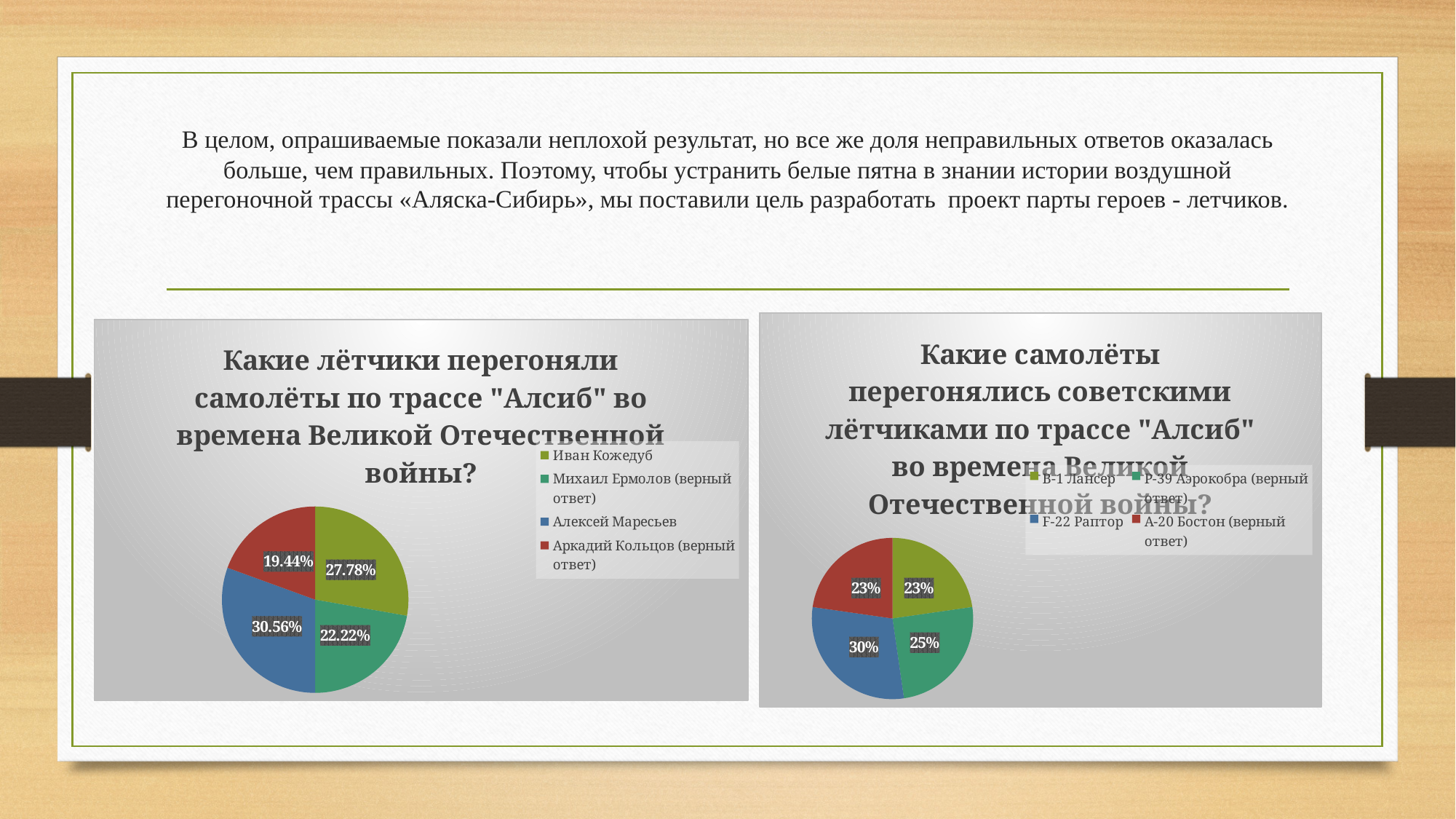
On the left pie chart, what is the difference between the shares for Иван Кожедуб and Аркадий Кольцов (верный ответ)? 8.34% On the left pie chart, which answer option has the smallest share? Аркадий Кольцов (верный ответ) On the left pie chart, which answer option has the largest share? Алексей Маресьев What type of chart is used on the right side of the slide? Pie chart On the left pie chart, what colour is the slice for Алексей Маресьев? Blue On the right pie chart, which is larger: the share for P-39 Аэрокобра (верный ответ) or the share for A-20 Бостон (верный ответ)? P-39 Аэрокобра (верный ответ) On the right pie chart, what share of respondents chose F-22 Раптор? 30% On the left pie chart, what share of respondents chose Михаил Ермолов (верный ответ)? 22.22% On the left pie chart, what share of respondents chose Алексей Маресьев? 30.56% How many slices does the left pie chart have? 4 On the right pie chart, what share of respondents chose P-39 Аэрокобра (верный ответ)? 25% On the right pie chart, which answer option has the largest share? F-22 Раптор